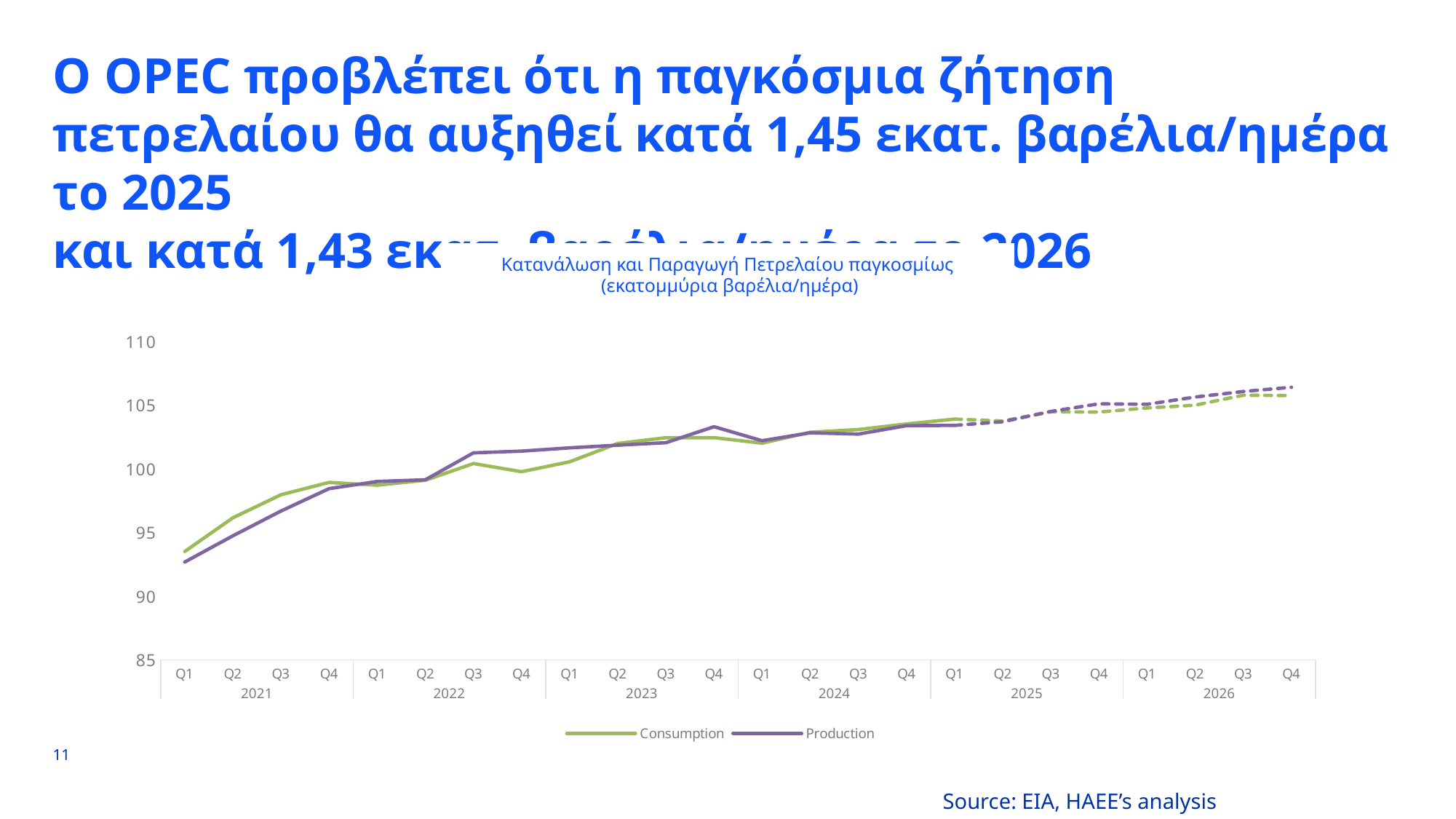
How many series does the legend list? 2 Is the Production value for Q1 2021 greater or less than 95? less Which two series are listed in the chart legend? Consumption and Production Do the Consumption values generally rise or fall from Q1 2021 to Q4 2026? Rise Which colour is used for the Production line? Purple In Q2 2021, which is higher, Consumption or Production? Consumption What kind of chart is shown on the slide? Line chart In Q4 2022, which is higher, Consumption or Production? Production How many quarterly points are plotted along the x axis for each series? 24 Is the Consumption value for Q4 2021 greater or less than 100? less Is the Consumption value for Q1 2021 greater or less than 95? less